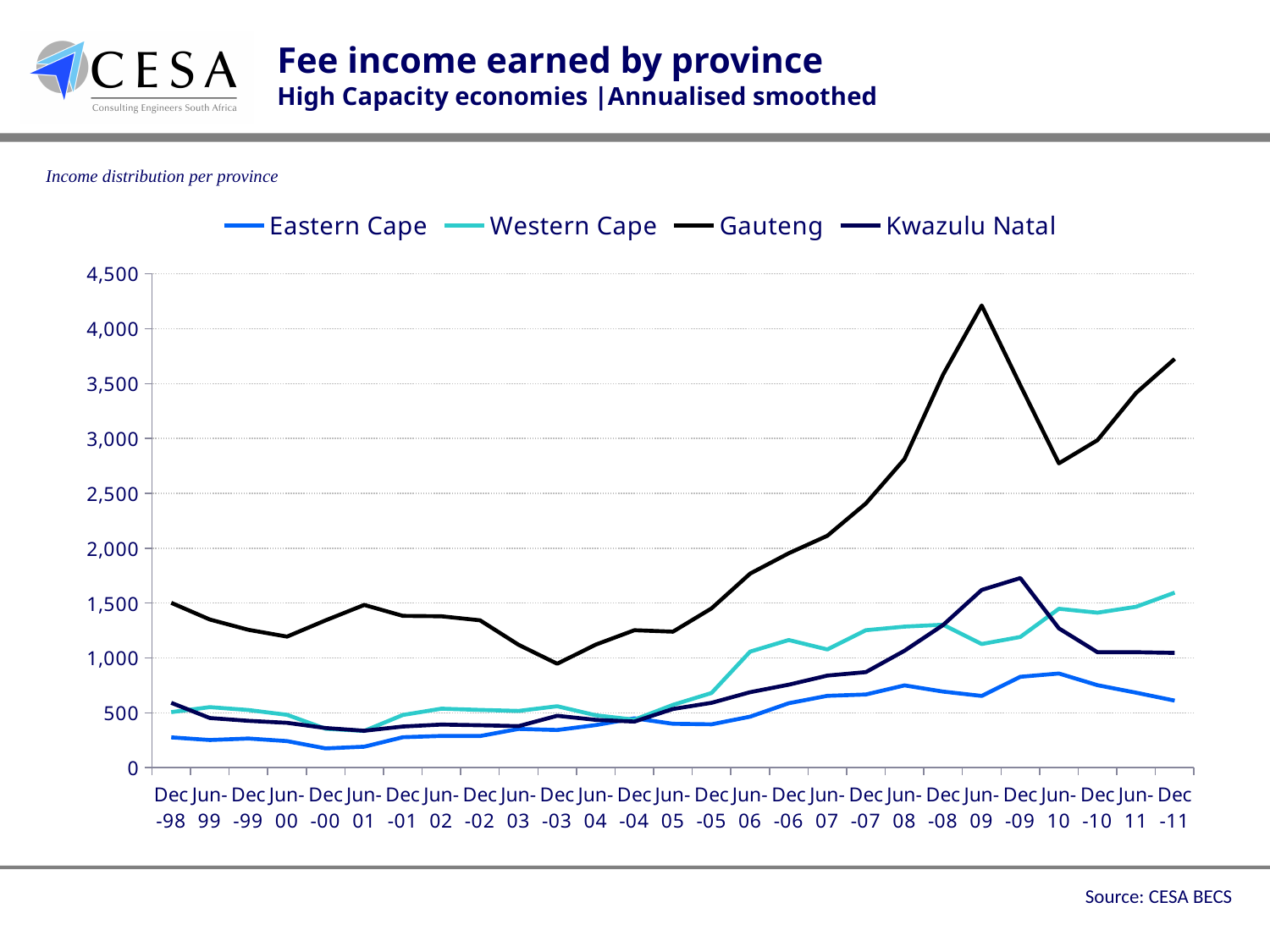
What kind of chart is shown on the slide? line chart Is the value for Gauteng at Jun-09 greater or less than 4,000? greater What colour is the Gauteng line in the legend? black Is the value for Eastern Cape at Dec-00 greater or less than 500? less Is the value for Gauteng at Jun-10 greater or less than 3,000? less Does the Gauteng line rise or fall between Jun-09 and Jun-10? fall At Dec-11, which is larger: Western Cape or Kwazulu Natal? Western Cape How many time points are shown along the x axis? 27 How many series does the legend list? 4 Which province has the lowest fee income at Dec-11? Eastern Cape Which province has the highest fee income at Jun-09? Gauteng